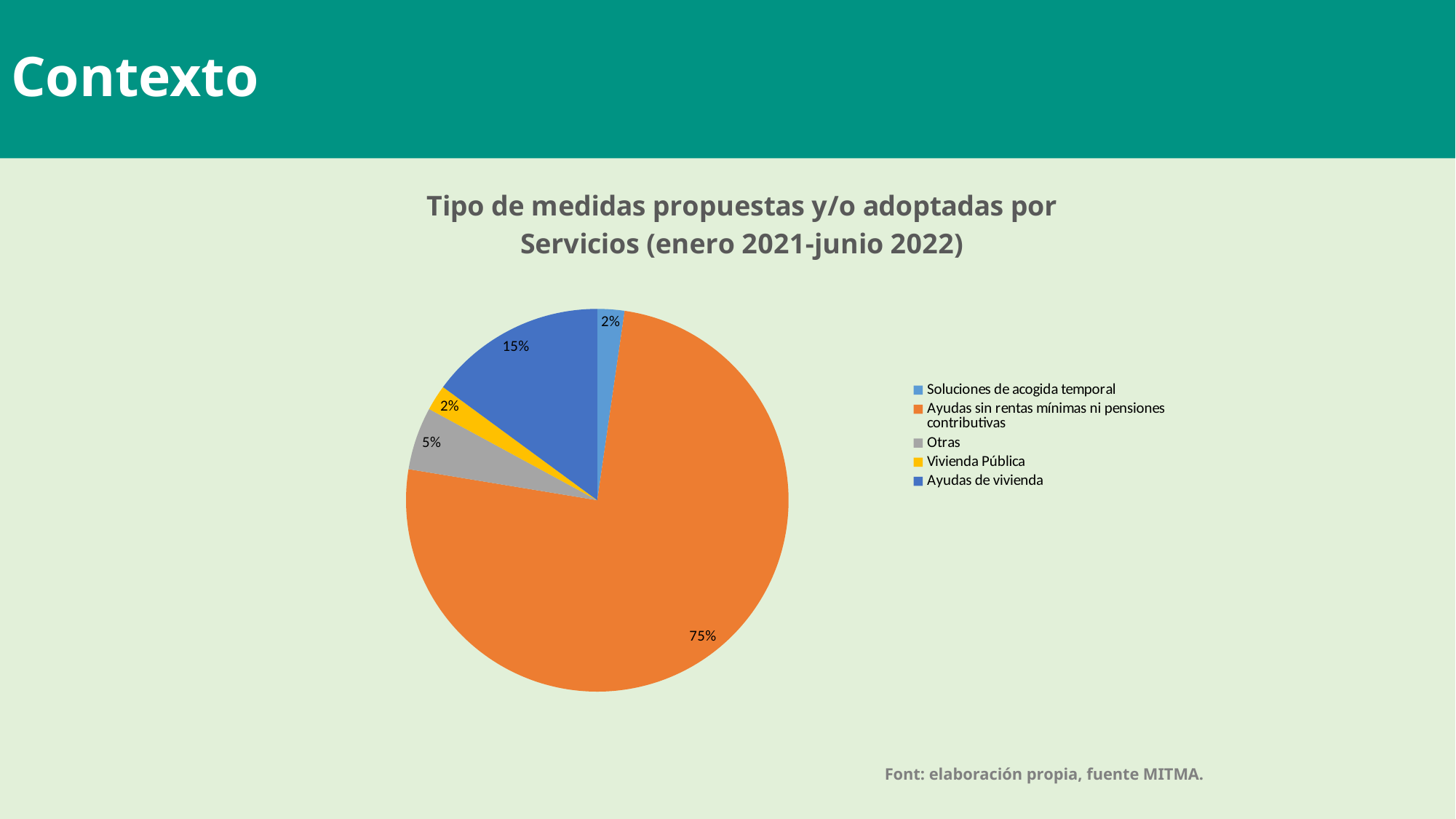
Which category has the largest slice of the pie? Ayudas sin rentas mínimas ni pensiones contributivas Which is larger, the slice for 'Otras' or the slice for 'Vivienda Pública'? Otras How many categories does the pie chart show? 5 What share of the pie does 'Ayudas sin rentas mínimas ni pensiones contributivas' represent? 75% What is the title of the chart? Tipo de medidas propuestas y/o adoptadas por Servicios (enero 2021-junio 2022) What is the difference in percentage points between 'Ayudas de vivienda' and 'Otras'? 10 percentage points What is the difference in percentage points between 'Ayudas sin rentas mínimas ni pensiones contributivas' and 'Ayudas de vivienda'? 60 percentage points What share of the pie does 'Soluciones de acogida temporal' represent? 2% What share of the pie does 'Ayudas de vivienda' represent? 15% What kind of chart is shown on the slide? Pie chart